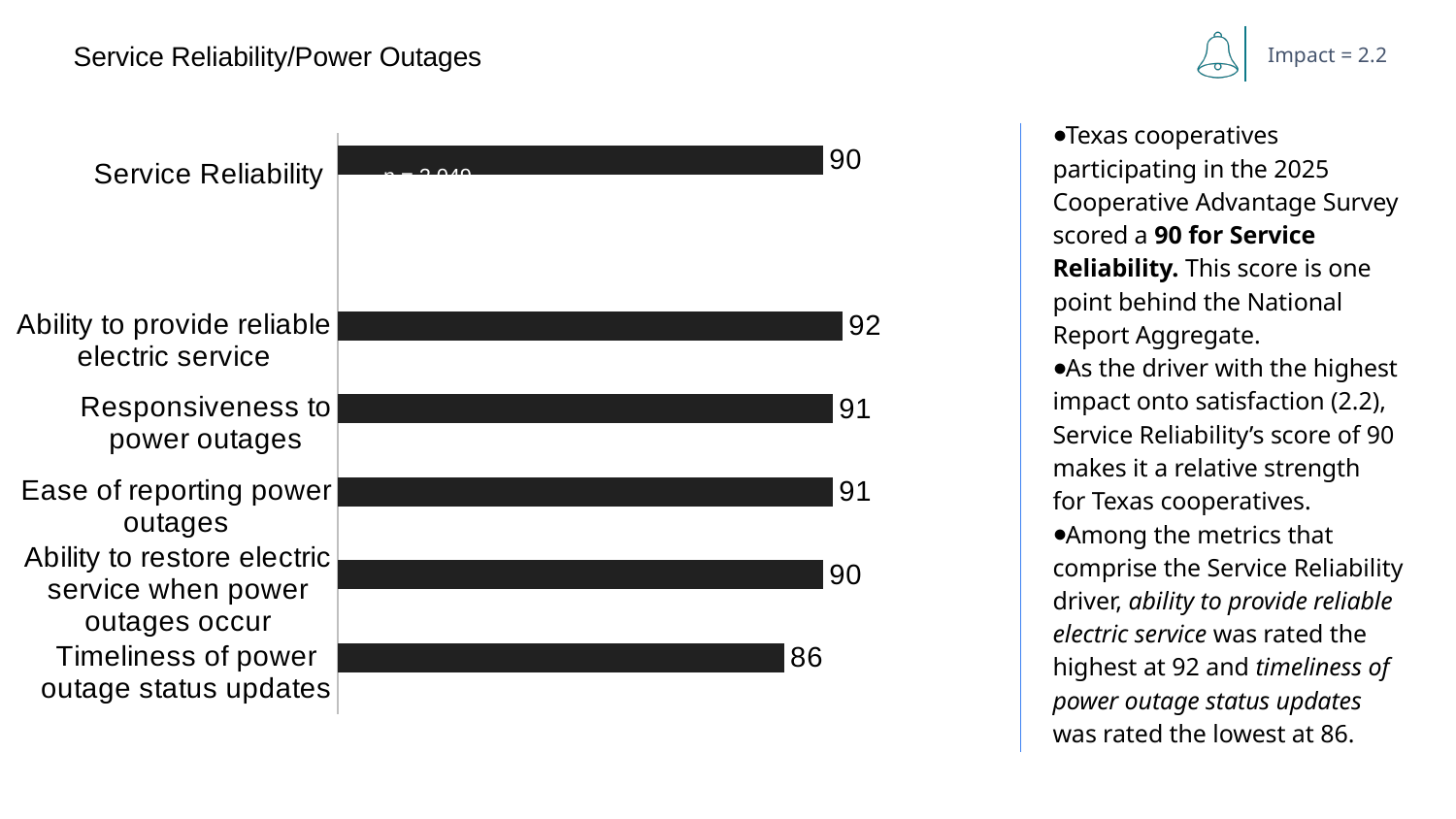
What is the value for Ability to provide reliable electric service? 92 What is the value for Timeliness of power outage status updates? 86 What is the title of the slide? Service Reliability/Power Outages What is the value for Ability to restore electric service when power outages occur? 90 Which category has the highest value? Ability to provide reliable electric service Which is larger, the value for Ease of reporting power outages or the value for Timeliness of power outage status updates? Ease of reporting power outages What kind of chart is shown on the slide? Bar chart What is the value for Service Reliability? 90 What is the difference between the values for Ability to provide reliable electric service and Timeliness of power outage status updates? 6 What is the value for Responsiveness to power outages? 91 Which category has the lowest value? Timeliness of power outage status updates How many categories are shown in the chart? 6